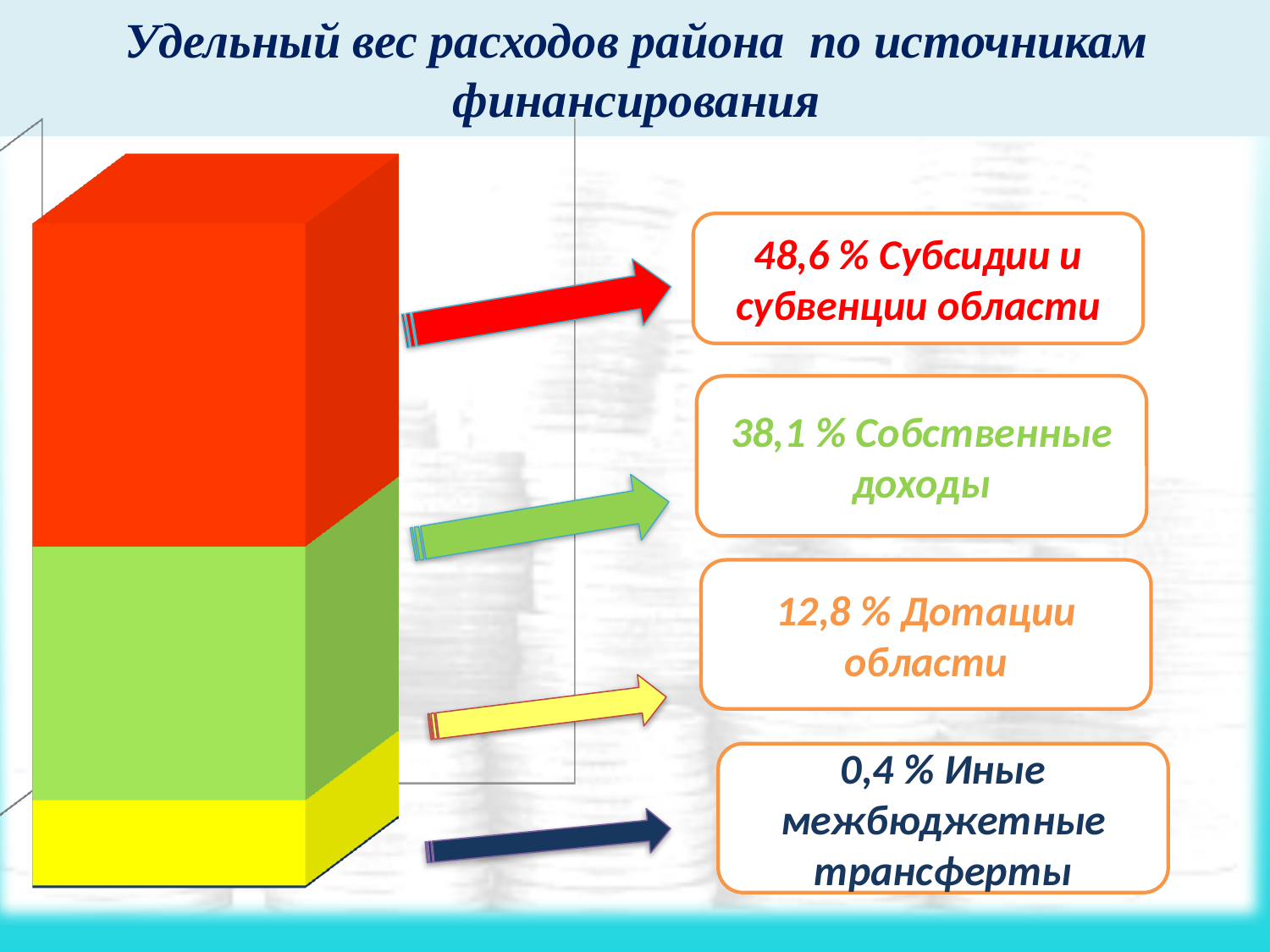
What share of the district's expenditures is financed by 'Субсидии и субвенции области'? 48,6 % Which source of financing has the smallest share of the district's expenditures? Иные межбюджетные трансферты What is the difference between the shares of 'Собственные доходы' and 'Дотации области'? 25,3 % Which source of financing has the largest share of the district's expenditures? Субсидии и субвенции области What share of the district's expenditures comes from 'Дотации области'? 12,8 % By how many percentage points does the share of 'Субсидии и субвенции области' exceed the share of 'Собственные доходы'? 10,5 % What share of the district's expenditures comes from 'Иные межбюджетные трансферты'? 0,4 % How many sources of financing are shown in the stacked bar? 4 What share of the district's expenditures comes from 'Собственные доходы'? 38,1 % What colour is the segment representing 'Собственные доходы'? Green What kind of chart is shown on the slide? Stacked bar chart Which is larger: the share of 'Дотации области' or the share of 'Собственные доходы'? Собственные доходы